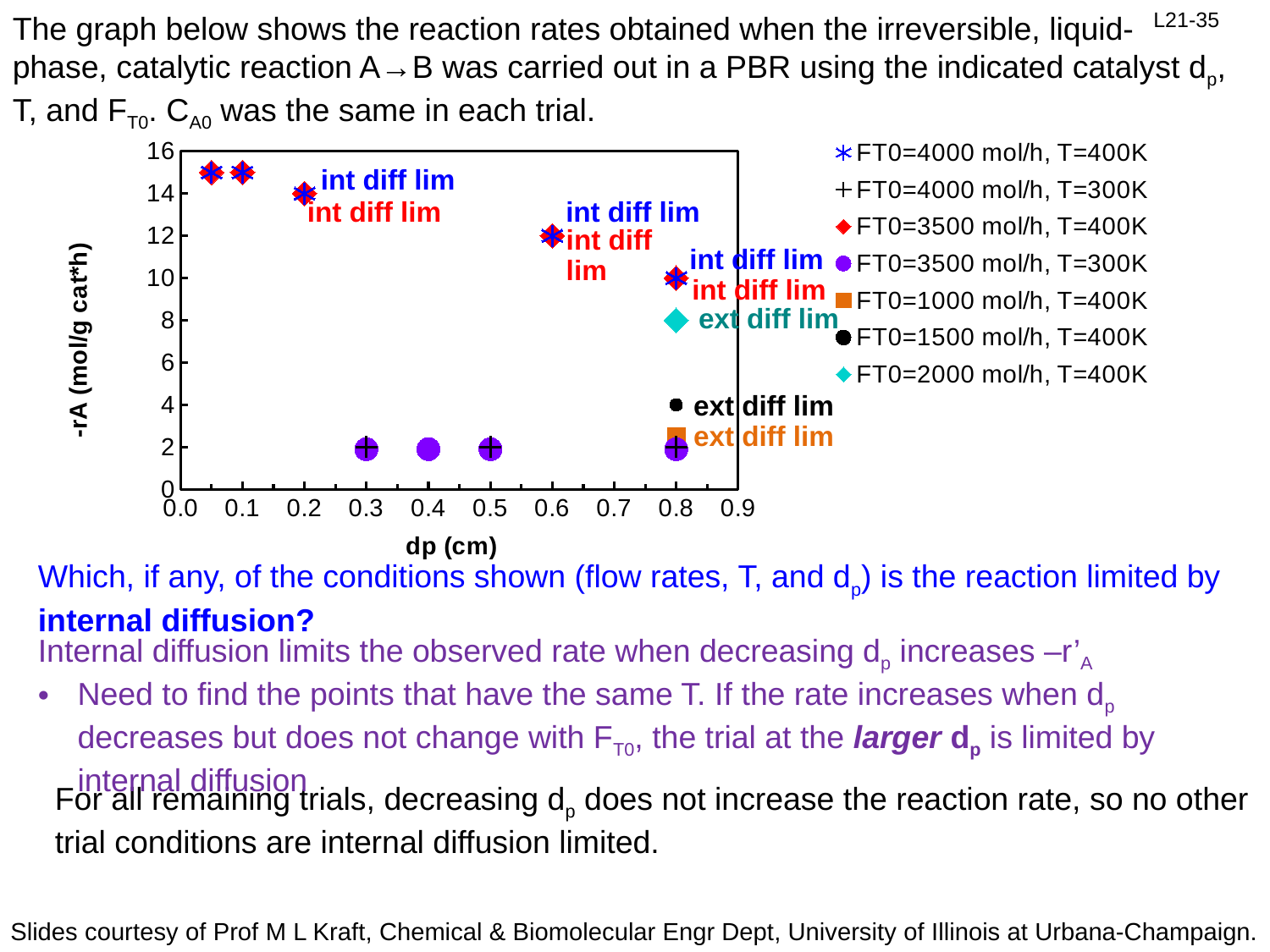
For the FT0=4000 mol/h, T=400K series, does -rA rise or fall as dp increases? fall Is the value of -rA for FT0=4000 mol/h, T=400K at dp = 0.1 cm greater or less than 14? greater What is the value of -rA for FT0=1500 mol/h, T=400K at dp = 0.8 cm? 4 What kind of chart is shown on the slide? scatter chart What is the title of the x axis? dp (cm) At dp = 0.8 cm, which has the larger -rA: FT0=2000 mol/h, T=400K or FT0=1500 mol/h, T=400K? FT0=2000 mol/h, T=400K What is the value of -rA for FT0=2000 mol/h, T=400K at dp = 0.8 cm? 8 Is the value of -rA for FT0=1000 mol/h, T=400K at dp = 0.8 cm greater or less than 4? less How many series does the legend list? 7 What is the value of -rA for FT0=4000 mol/h, T=400K at dp = 0.6 cm? 12 For FT0=4000 mol/h, T=400K, what is the difference in -rA between dp = 0.2 cm and dp = 0.8 cm? 4